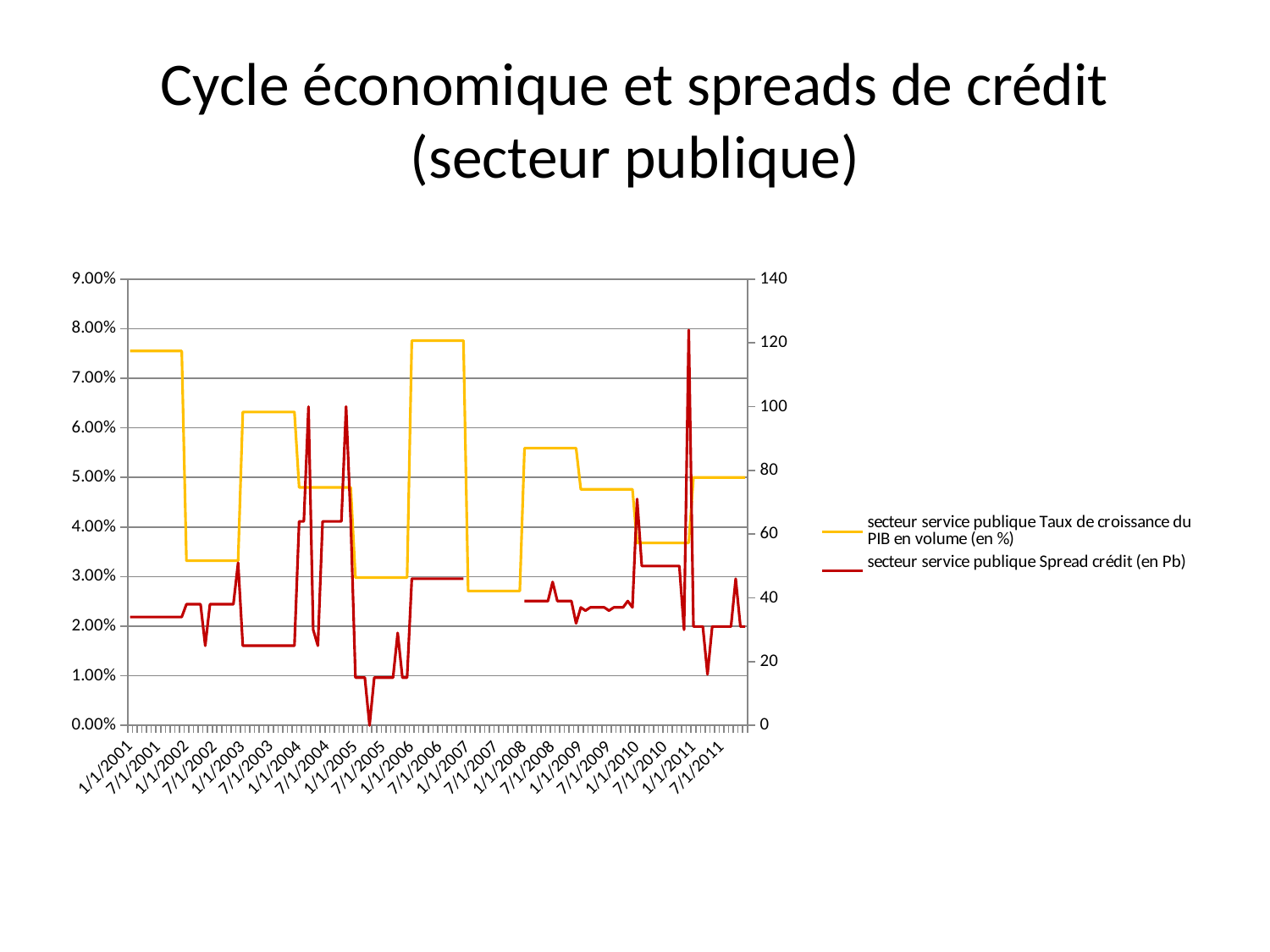
Is the value of the GDP growth series (Taux de croissance du PIB) at 7/1/2005 greater or less than 4.00%? less What is the title of the slide's chart? Cycle économique et spreads de crédit (secteur publique) Is the value of the GDP growth series (Taux de croissance du PIB) at 7/1/2006 greater or less than 7.00%? greater Is the peak value of the credit spread series (Spread crédit) around 1/1/2011 greater or less than 100? greater What is the maximum value shown on the right-hand vertical axis? 140 What kind of chart is shown on the slide? line chart How many series does the legend list? 2 Does the GDP growth series (Taux de croissance du PIB) rise or fall between 7/1/2001 and 7/1/2002? fall Which series is drawn in dark red? secteur service publique Spread crédit (en Pb) Around which x-axis date does the credit spread series (Spread crédit) reach its highest value? 1/1/2011